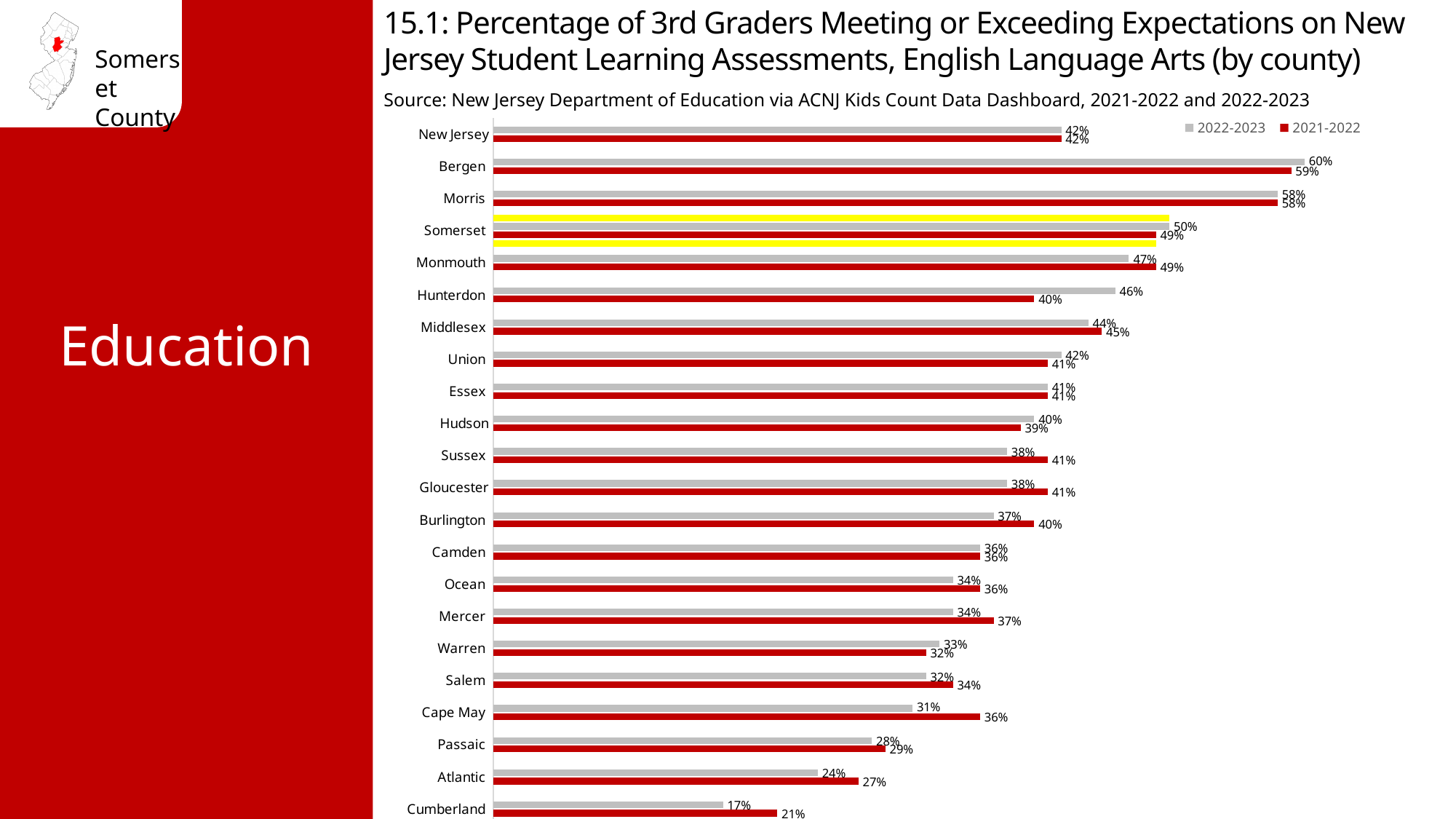
Which is larger for Cape May: the 2022-2023 value or the 2021-2022 value? 2021-2022 Which county has the highest 2022-2023 value? Bergen What is the 2022-2023 value for Cape May? 31% What is the 2022-2023 value for Somerset? 50% What is the difference between Bergen's and Cumberland's 2022-2023 values? 43% Which county has the lowest 2021-2022 value? Cumberland Which category's bars are highlighted in yellow on the chart? Somerset How many series does the legend list? 2 How many categories (counties plus New Jersey) are shown on the chart? 22 What kind of chart is shown on the slide? Bar chart What is the 2021-2022 value for Hunterdon? 40% What is the difference between Hunterdon's 2022-2023 and 2021-2022 values? 6%